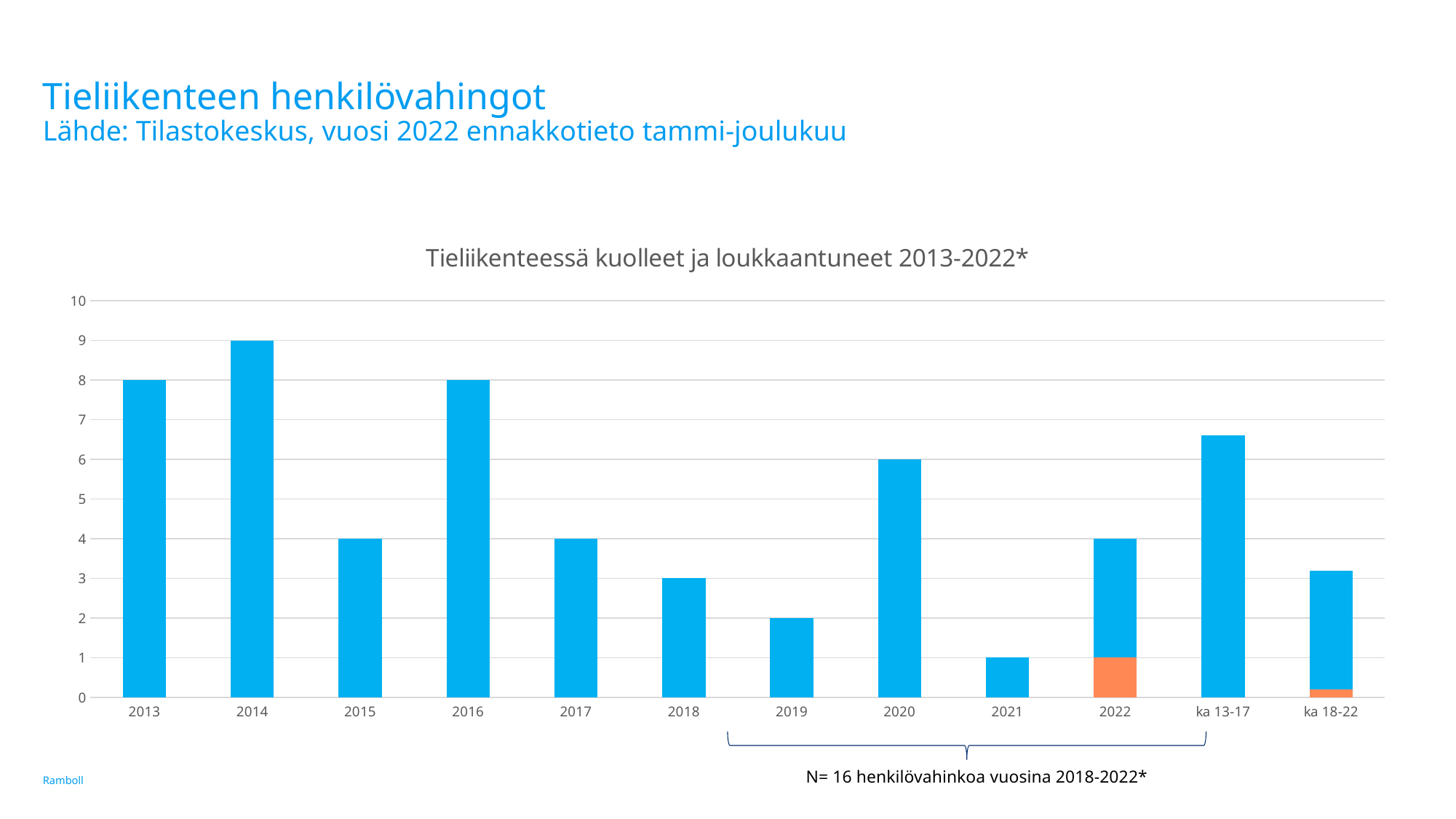
What is the value for 2021? 1 Is the value for ka 13-17 greater or less than 6? greater What is the difference between the values for 2013 and 2018? 5 Which year from 2013 to 2022 has the highest bar? 2014 Which is larger, the value for 2015 or the value for 2019? 2015 Which year from 2013 to 2022 has the lowest bar? 2021 What kind of chart is shown on the slide? bar chart What is the value for 2020? 6 What is the value for 2014? 9 How many categories are shown on the x axis? 12 What is the total height of the stacked bar for 2022? 4 What is the chart's title? Tieliikenteessä kuolleet ja loukkaantuneet 2013-2022*